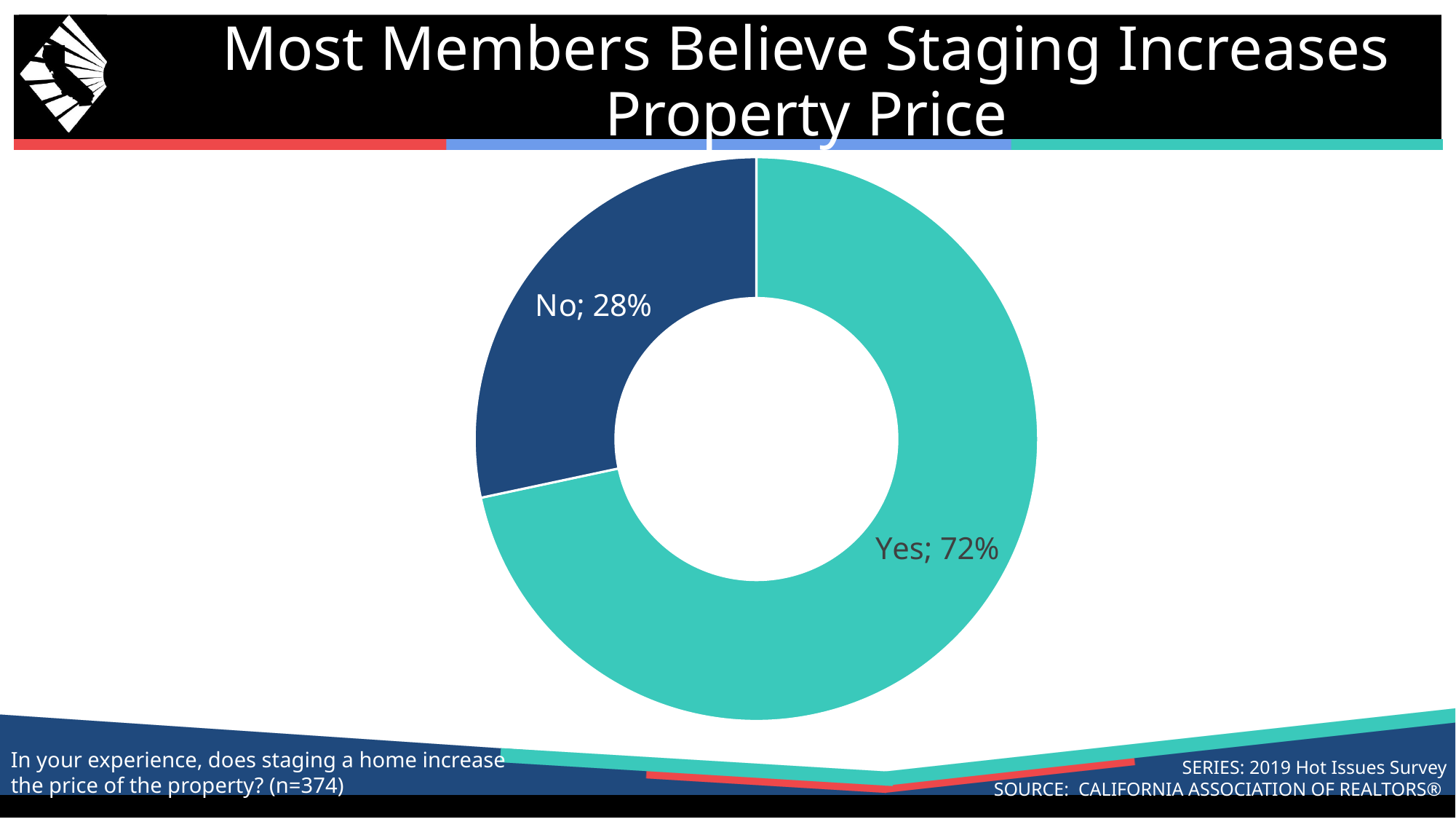
Which response has the smallest share of the chart? No What colour is the "Yes" slice of the chart? Teal What share of the chart does the "No" slice represent? 28% What percentage of members answered "Yes" to whether staging increases the price of the property? 72% Which response has the largest share of the chart? Yes What is the title of the slide? Most Members Believe Staging Increases Property Price What percentage of members answered "No" to whether staging increases the price of the property? 28% What is the sample size (n) of the survey question shown on the slide? 374 Which response is larger, "Yes" or "No"? Yes What kind of chart is shown on the slide? Pie chart (doughnut) What is the difference in percentage points between the "Yes" and "No" responses? 44 How many response categories are shown in the chart? 2